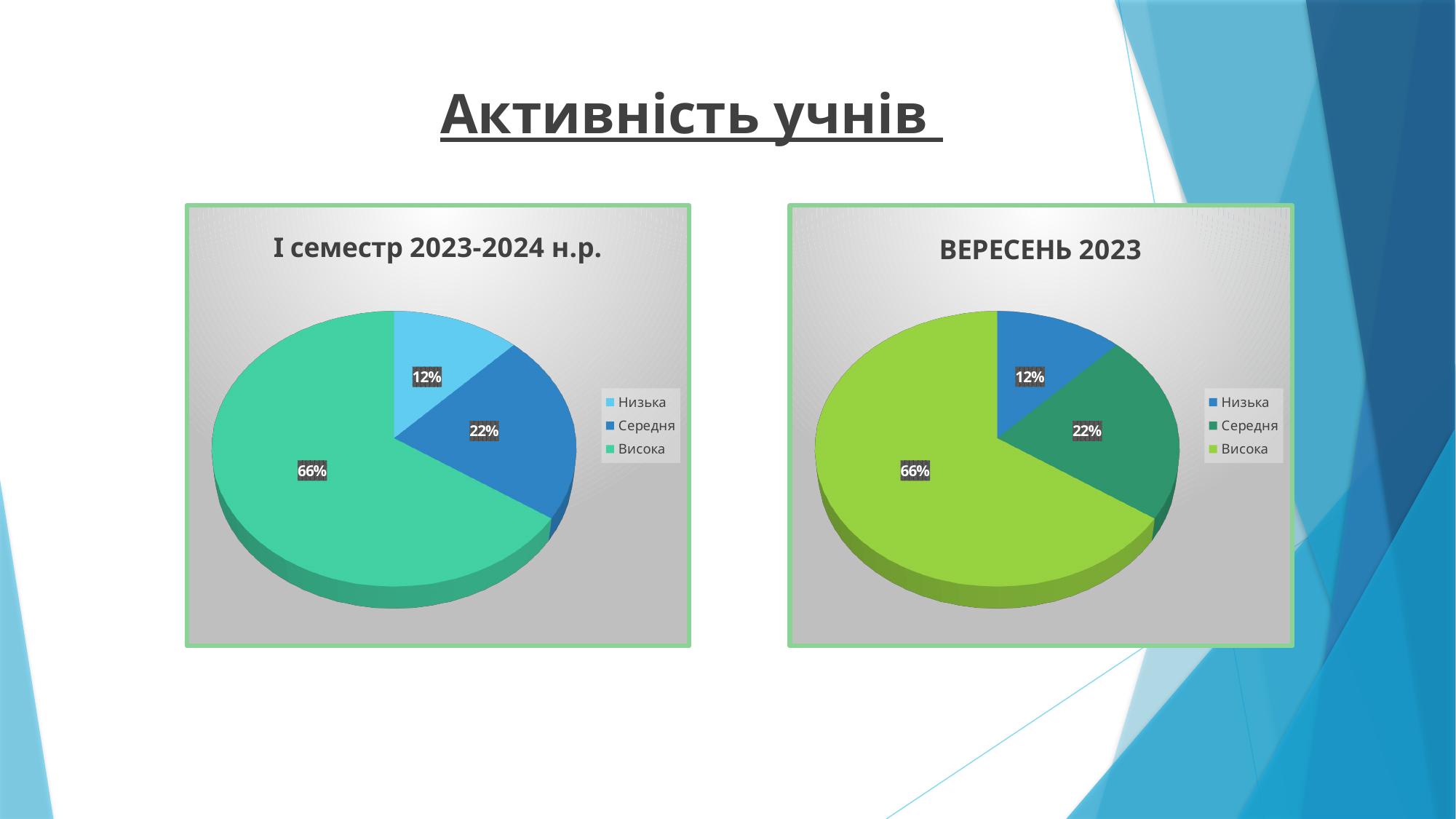
In the chart titled 'ВЕРЕСЕНЬ 2023', what is the value for 'Середня'? 22% What type of chart is the chart titled 'ВЕРЕСЕНЬ 2023'? Pie chart In the chart titled 'ВЕРЕСЕНЬ 2023', what share does the 'Низька' slice have? 12% In the chart titled 'І семестр 2023-2024 н.р.', which category has the largest slice? Висока How many slices does the chart titled 'І семестр 2023-2024 н.р.' have? 3 In the chart titled 'І семестр 2023-2024 н.р.', what is the difference between the 'Висока' and 'Середня' values? 44% What is the title of the chart on the left side of the slide? І семестр 2023-2024 н.р. In the chart titled 'ВЕРЕСЕНЬ 2023', which is larger, 'Середня' or 'Низька'? Середня In the chart titled 'І семестр 2023-2024 н.р.', what share does the 'Висока' slice have? 66% In the chart titled 'І семестр 2023-2024 н.р.', what is the value for 'Середня'? 22% In the chart titled 'ВЕРЕСЕНЬ 2023', which category has the smallest slice? Низька In the chart titled 'ВЕРЕСЕНЬ 2023', what is the difference between the 'Середня' and 'Низька' values? 10%